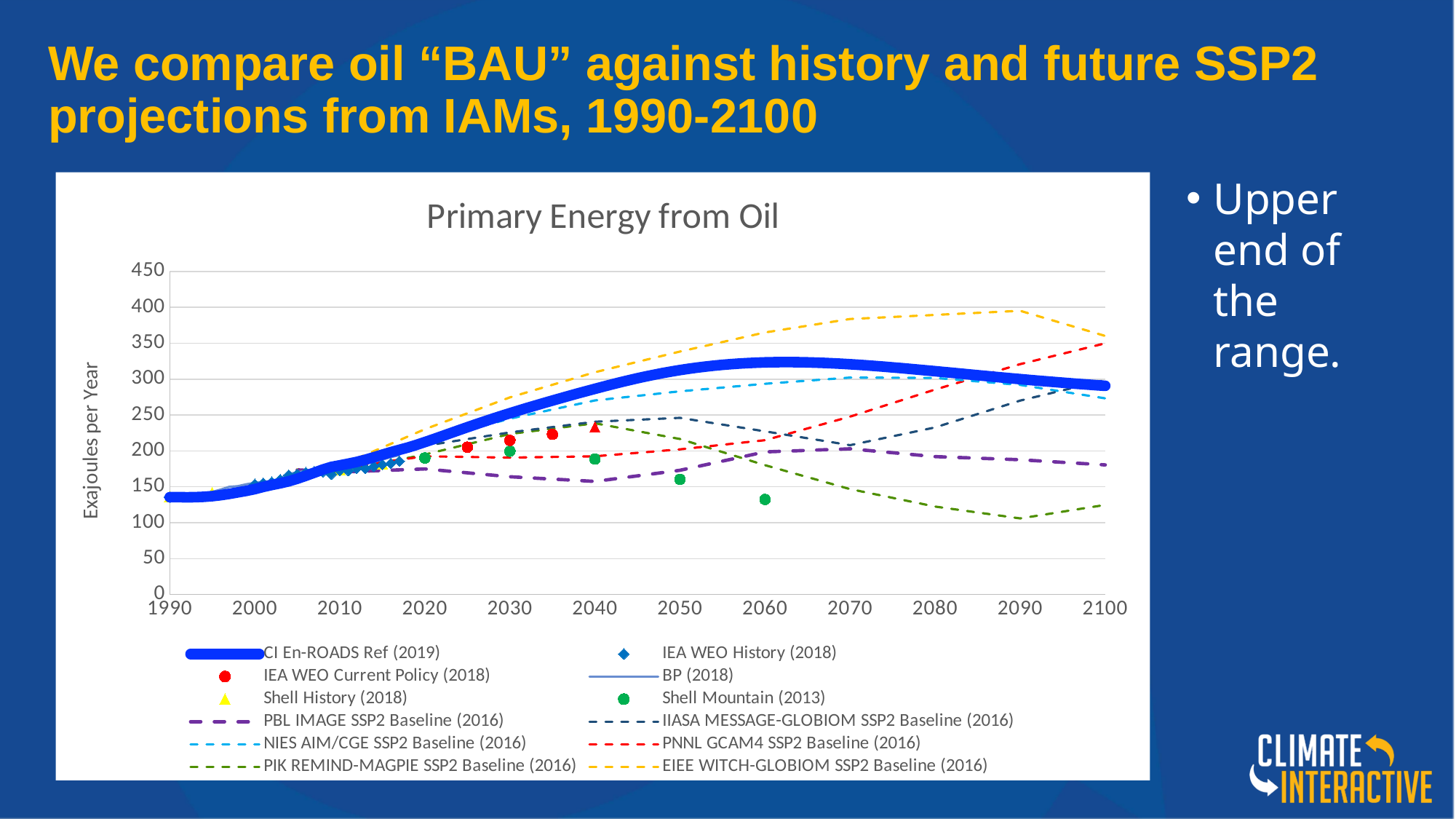
Is the value of EIEE WITCH-GLOBIOM SSP2 Baseline (2016) in 2090 greater or less than 350? greater Which series reaches the highest value on the chart? EIEE WITCH-GLOBIOM SSP2 Baseline (2016) Is the value of PIK REMIND-MAGPIE SSP2 Baseline (2016) in 2090 greater or less than 150? less Is the value of CI En-ROADS Ref (2019) in 2060 greater or less than 300? greater Which series reaches the lowest value after 2040 on the chart? PIK REMIND-MAGPIE SSP2 Baseline (2016) Does the PIK REMIND-MAGPIE SSP2 Baseline (2016) line rise or fall between 2040 and 2090? fall In 2100, which is higher: PNNL GCAM4 SSP2 Baseline (2016) or PBL IMAGE SSP2 Baseline (2016)? PNNL GCAM4 SSP2 Baseline (2016) What is the label on the vertical axis of the chart? Exajoules per Year What is the title of the chart? Primary Energy from Oil How many series does the chart's legend list? 12 What kind of chart is shown on the slide? Line chart